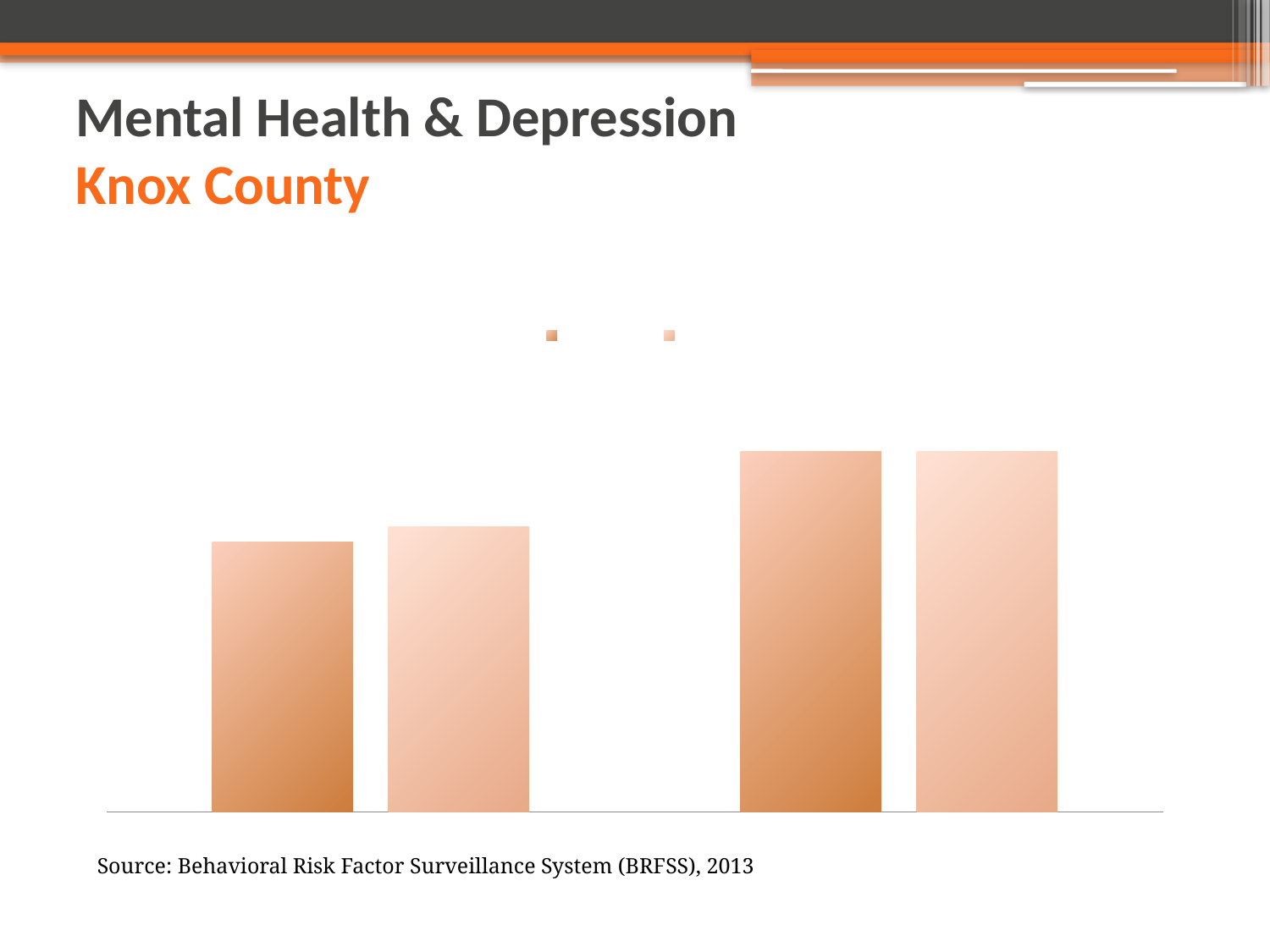
Into how many groups are the bars arranged along the x axis? 2 Is the leftmost bar taller or shorter than the second bar from the left? shorter How many series does the chart's legend show? 2 Which bar is the shortest in the chart: the leftmost bar or the rightmost bar? the leftmost bar What kind of chart is shown on the slide? bar chart Are the two bars in the right-hand group taller or shorter than the two bars in the left-hand group? taller What is the source cited below the chart? Behavioral Risk Factor Surveillance System (BRFSS), 2013 How many bars are plotted in the chart? 4